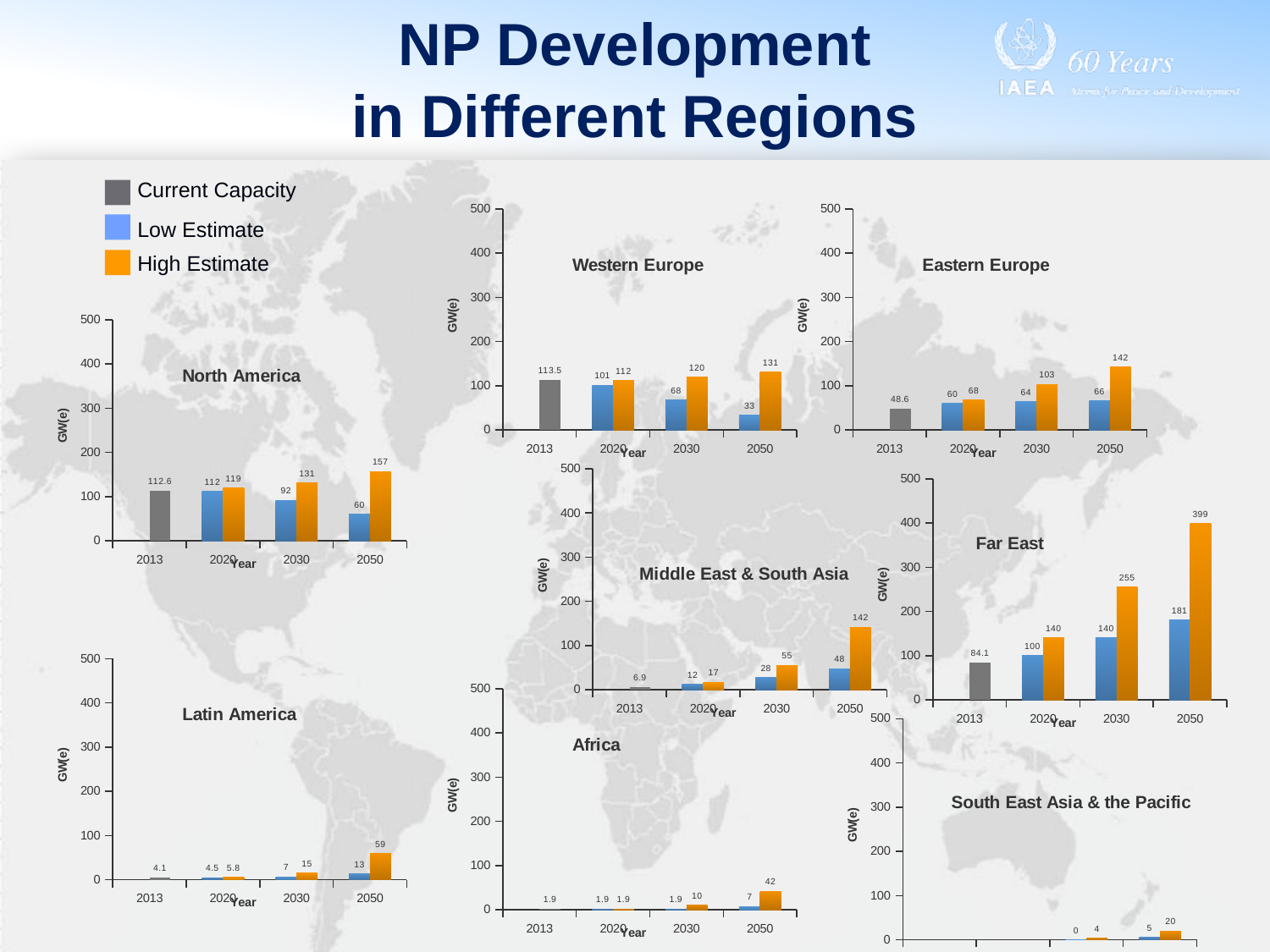
In the Far East chart, what is the high estimate for 2050? 399 In the Western Europe chart, does the low estimate rise or fall from 2020 to 2050? fall In the Middle East & South Asia chart, which year has the highest high estimate? 2050 In the Latin America chart, which is larger for 2050, the low estimate or the high estimate? High estimate In the Western Europe chart, what is the low estimate for 2050? 33 In the Far East chart, what is the difference between the high estimate and the low estimate for 2050? 218 In the Eastern Europe chart, what is the high estimate for 2030? 103 What kind of chart is the North America chart? Bar chart In the North America chart, what is the current capacity shown for 2013? 112.6 In the Africa chart, what is the high estimate for 2050? 42 How many years are shown on the x axis of the North America chart? 4 How many series does the legend on the slide list? 3